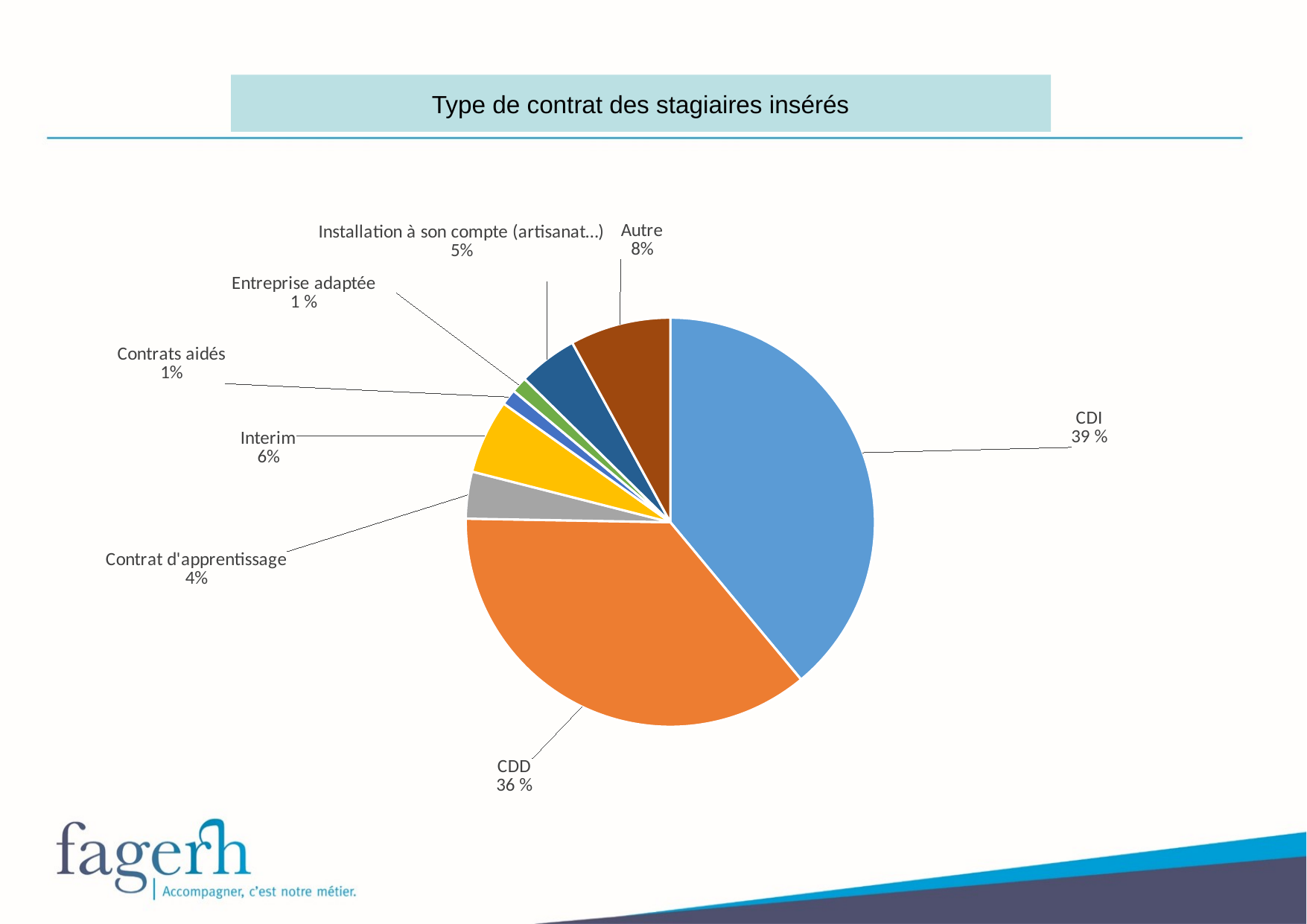
Which category has the largest slice of the pie? CDI How many slices does the pie chart have? 8 What is the difference in percentage points between CDI and CDD? 3 What kind of chart is shown on the slide? pie chart What is the share for Interim? 6% What is the title of the chart? Type de contrat des stagiaires insérés What is the share for Installation à son compte (artisanat…)? 5% What is the share for CDD? 36 % What is the share for Contrat d'apprentissage? 4% What is the share for Autre? 8% What is the share for CDI? 39 % Which is larger, the share for Autre or the share for Interim? Autre